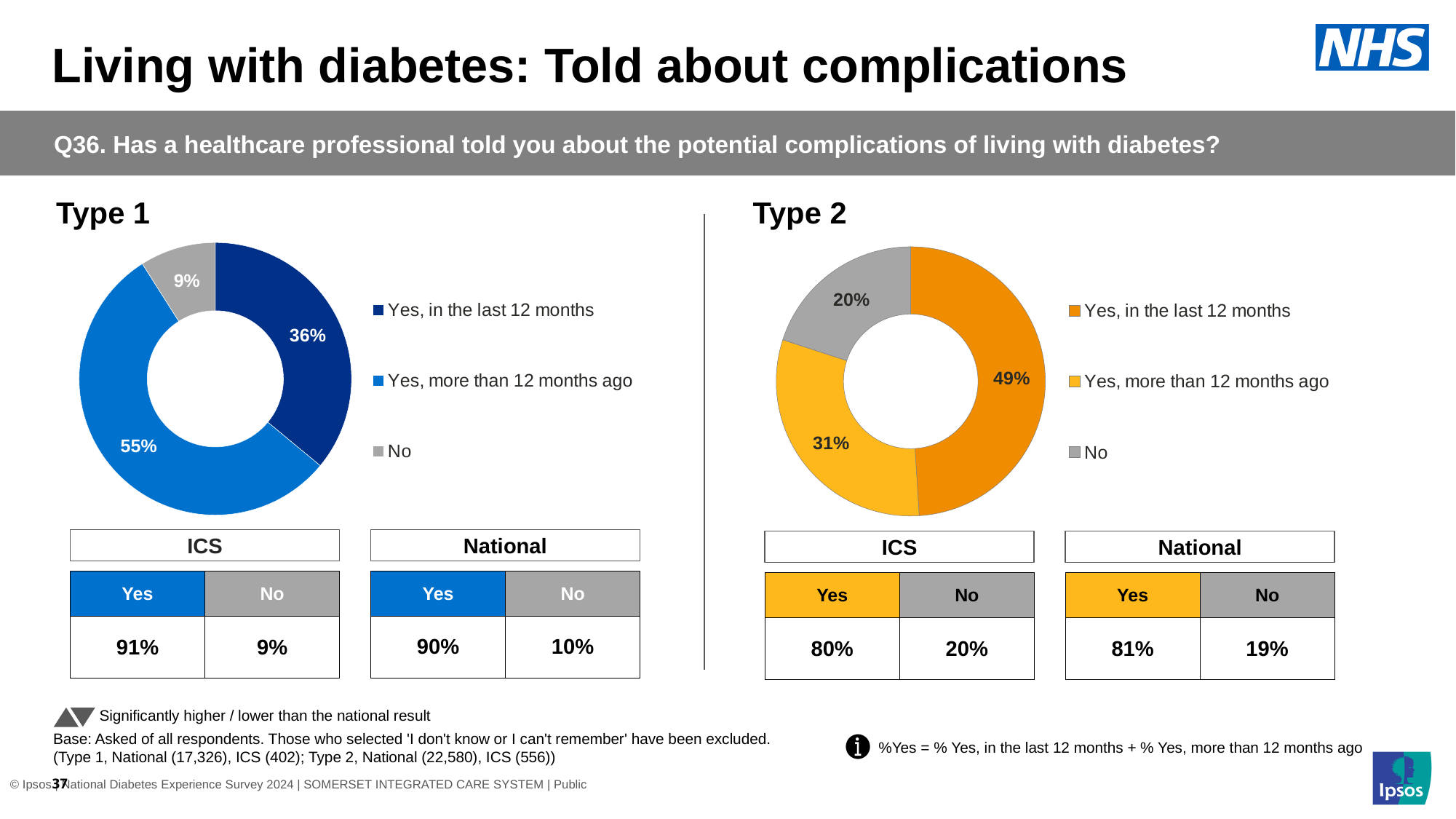
In the Type 1 chart, what percentage of respondents said 'Yes, in the last 12 months'? 36% In the Type 2 chart, what is the difference between the 'Yes, in the last 12 months' share and the 'Yes, more than 12 months ago' share? 18% In the Type 1 chart, what percentage of respondents said 'Yes, more than 12 months ago'? 55% In the Type 2 chart, what percentage of respondents said 'No'? 20% What kind of chart is used for Type 1? Doughnut chart In the Type 2 chart, what percentage of respondents said 'Yes, in the last 12 months'? 49% What colour represents 'No' in both the Type 1 and Type 2 charts? Grey In the Type 2 chart, which category has the smallest share? No In the Type 1 chart, what is the combined share of the two 'Yes' categories? 91% In the Type 1 chart, which is larger: 'Yes, in the last 12 months' or 'No'? Yes, in the last 12 months How many categories does the Type 2 chart show? 3 In the Type 1 chart, which category has the largest share? Yes, more than 12 months ago